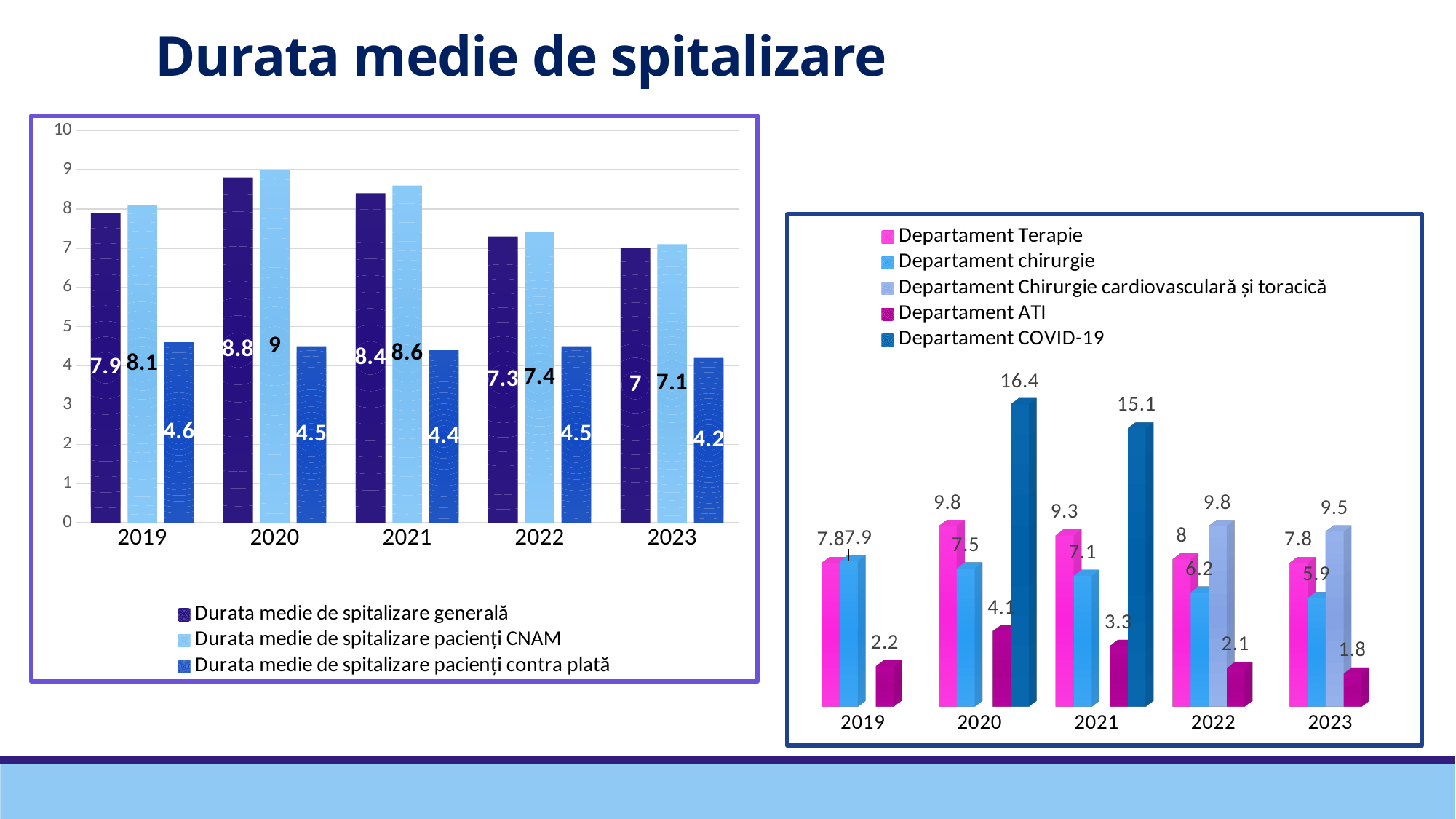
In the right chart, what is the value for 'Departament COVID-19' in 2020? 16.4 In the right chart, which department has the lowest value in 2022? Departament ATI In the left chart, what is the value of 'Durata medie de spitalizare pacienți CNAM' for 2020? 9 In the left chart, does 'Durata medie de spitalizare generală' rise or fall from 2021 to 2023? fall In the left chart, what is the value of 'Durata medie de spitalizare pacienți contra plată' for 2023? 4.2 In the left chart, which year has the highest value for 'Durata medie de spitalizare generală'? 2020 In the right chart, what is the value for 'Departament ATI' in 2023? 1.8 In the left chart, how many series does the legend list? 3 In the right chart, how many series does the legend list? 5 In the left chart, what is the difference between 'Durata medie de spitalizare generală' and 'Durata medie de spitalizare pacienți contra plată' in 2019? 3.3 In the right chart, which is larger in 2023: 'Departament Terapie' or 'Departament Chirurgie cardiovasculară și toracică'? Departament Chirurgie cardiovasculară și toracică What kind of chart is the left chart? bar chart